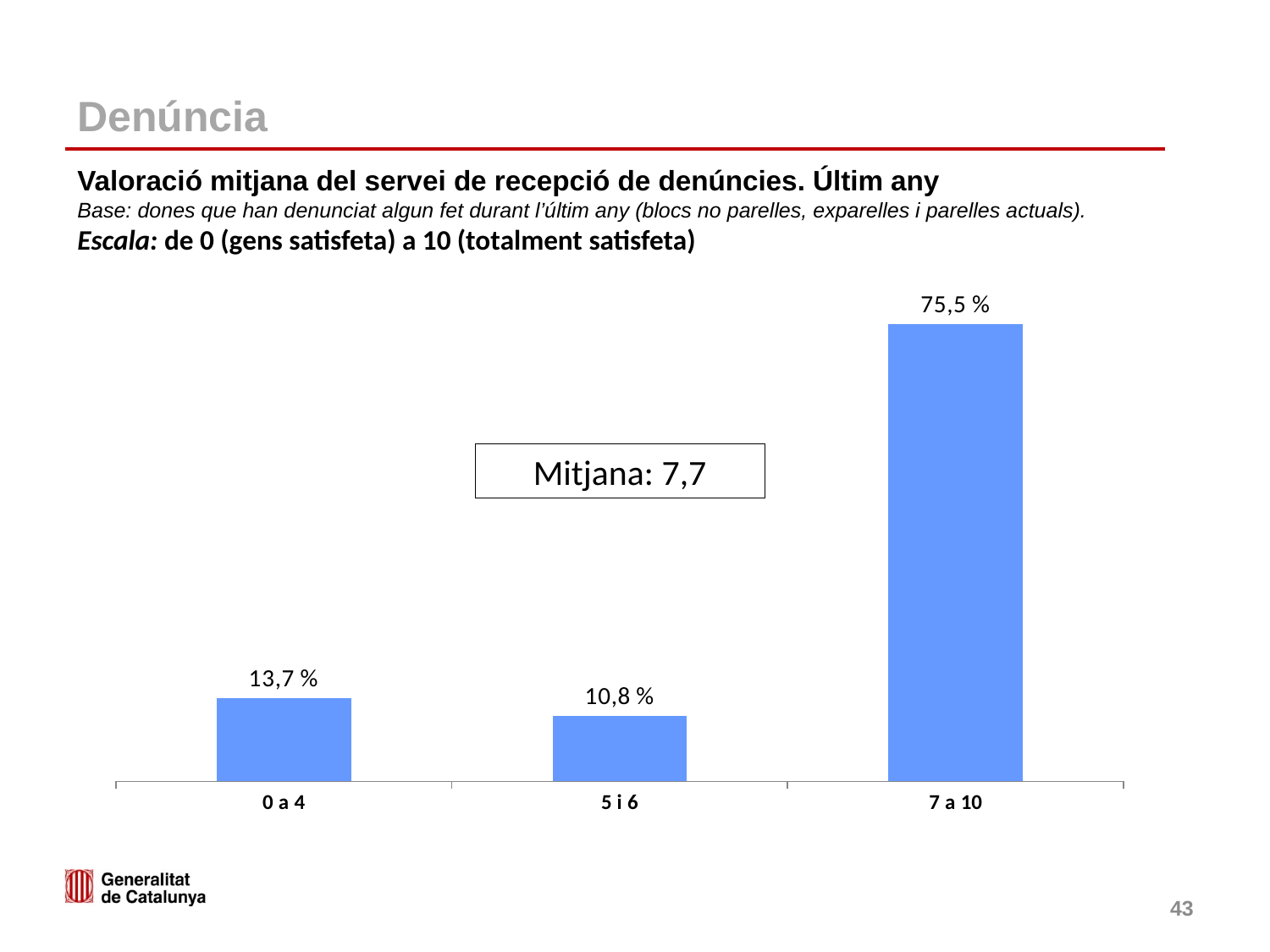
What is the title of the chart? Valoració mitjana del servei de recepció de denúncies. Últim any How many categories are shown on the x axis? 3 What is the mean value (Mitjana) shown in the box on the chart? 7,7 What is the value for the '5 i 6' category? 10,8 % What is the value for the '7 a 10' category? 75,5 % Which category has the lowest value? 5 i 6 What is the value for the '0 a 4' category? 13,7 % Which is larger, the value for '0 a 4' or the value for '5 i 6'? 0 a 4 What is the difference between the values for '0 a 4' and '5 i 6'? 2,9 % What is the difference between the values for '7 a 10' and '0 a 4'? 61,8 % What kind of chart is shown on the slide? bar chart Which category has the highest value? 7 a 10